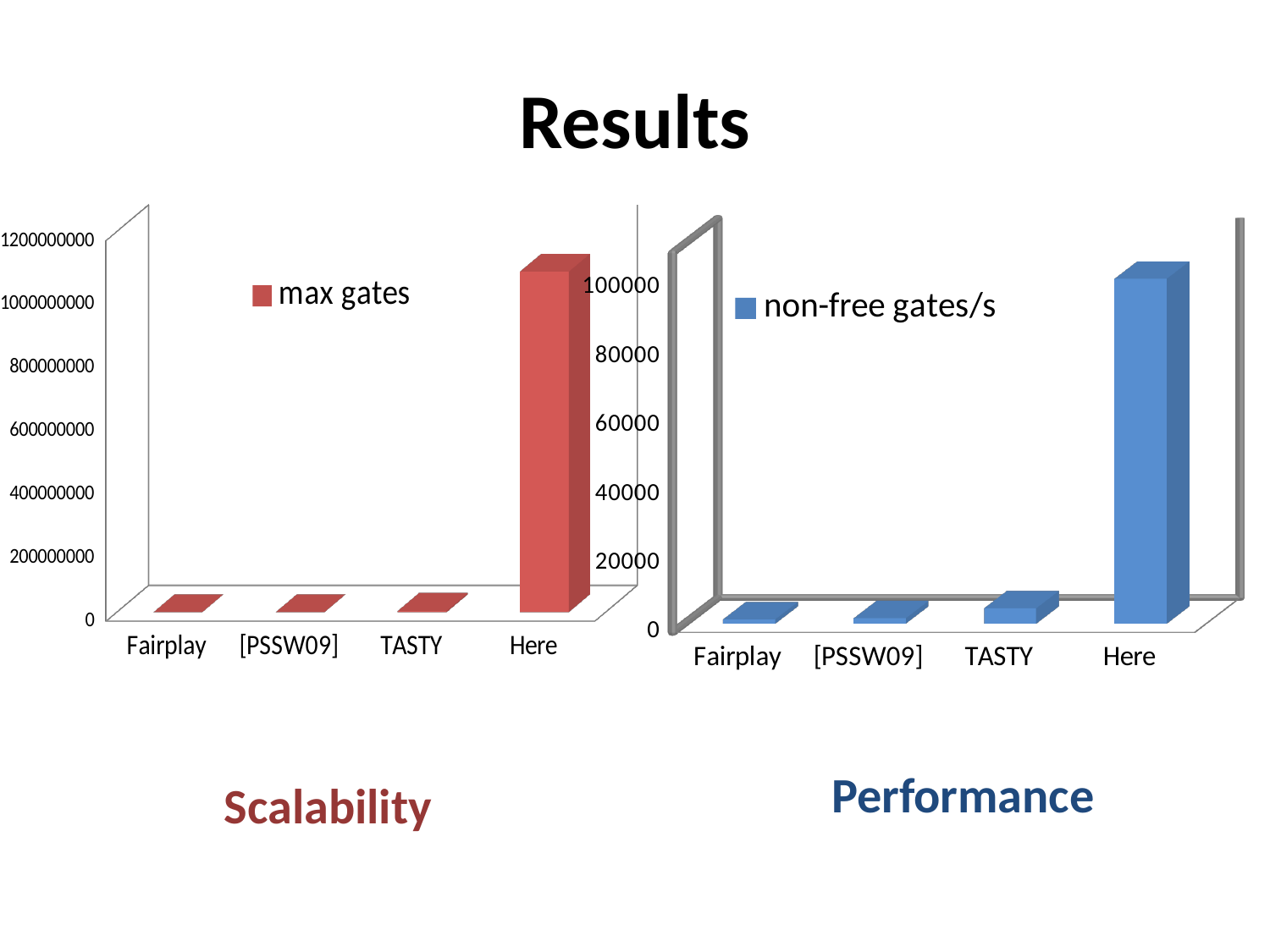
In the Performance chart, which category has the highest non-free gates/s value? Here How many categories are shown on the x axis of the Scalability chart? 4 In the Performance chart, is the value for Here greater or less than 80000? greater What kind of chart is the Performance chart on the right? bar chart In the Scalability chart, which is larger, the value for Here or the value for TASTY? Here In the Performance chart, is the value for TASTY greater or less than 20000? less What series name appears in the legend of the Performance chart? non-free gates/s How many series does the legend of the Performance chart list? 1 What kind of chart is the Scalability chart on the left? bar chart In the Scalability chart, is the value for Here greater or less than 800000000? greater What series name appears in the legend of the Scalability chart? max gates In the Scalability chart, which category has the highest max gates value? Here